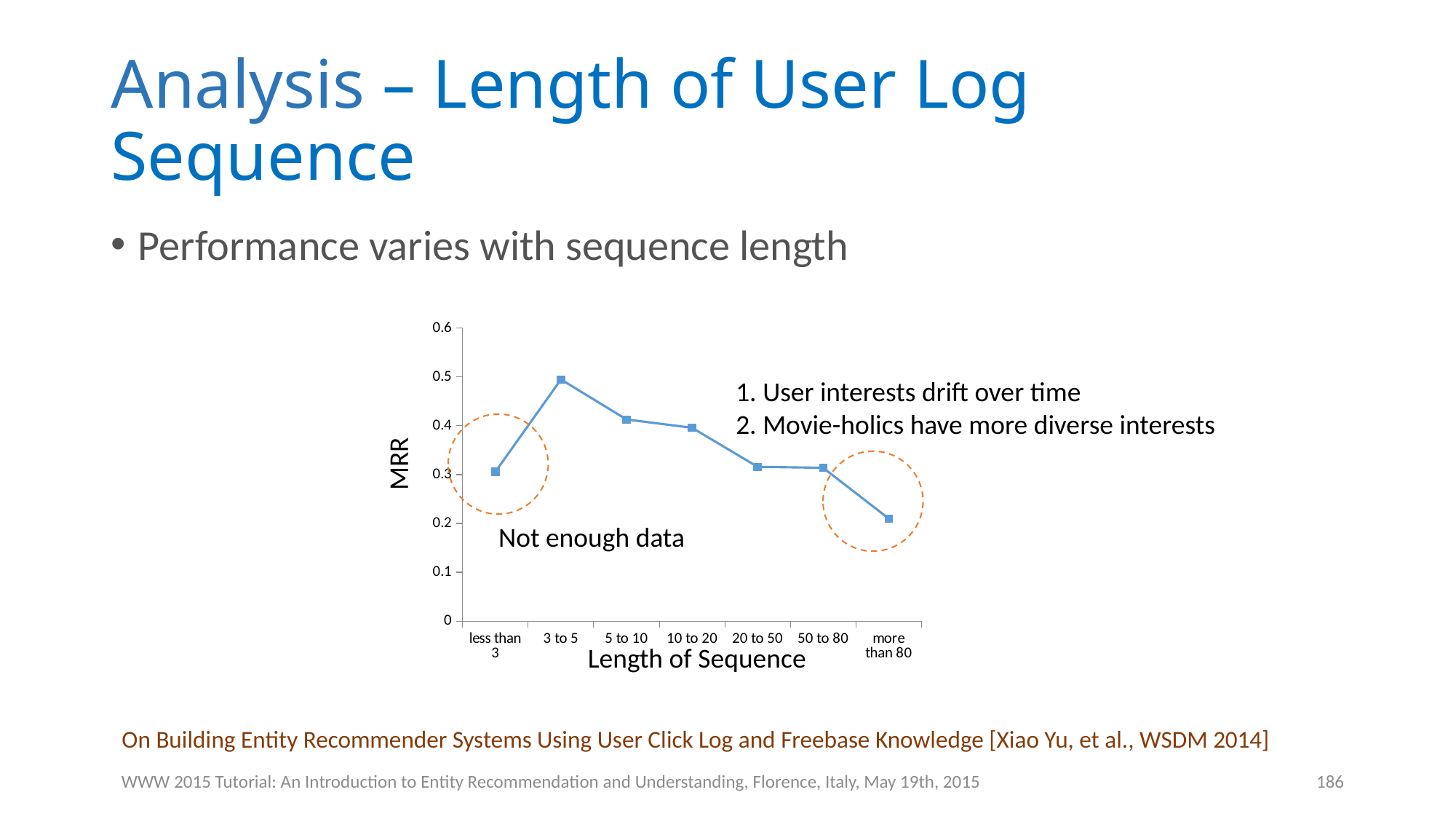
Which has a higher MRR, "less than 3" or "3 to 5"? 3 to 5 Is the MRR for "3 to 5" greater or less than 0.4? greater Which has a higher MRR, "5 to 10" or "more than 80"? 5 to 10 Is the MRR for "less than 3" greater or less than 0.4? less From "3 to 5" onward, does the MRR generally rise or fall as sequence length increases? fall Is the MRR for "50 to 80" greater or less than 0.4? less What is the label on the y axis of the chart? MRR Which sequence-length category has the highest MRR? 3 to 5 Which sequence-length category has the lowest MRR? more than 80 What kind of chart is shown on the slide? line chart How many sequence-length categories are plotted on the x axis? 7